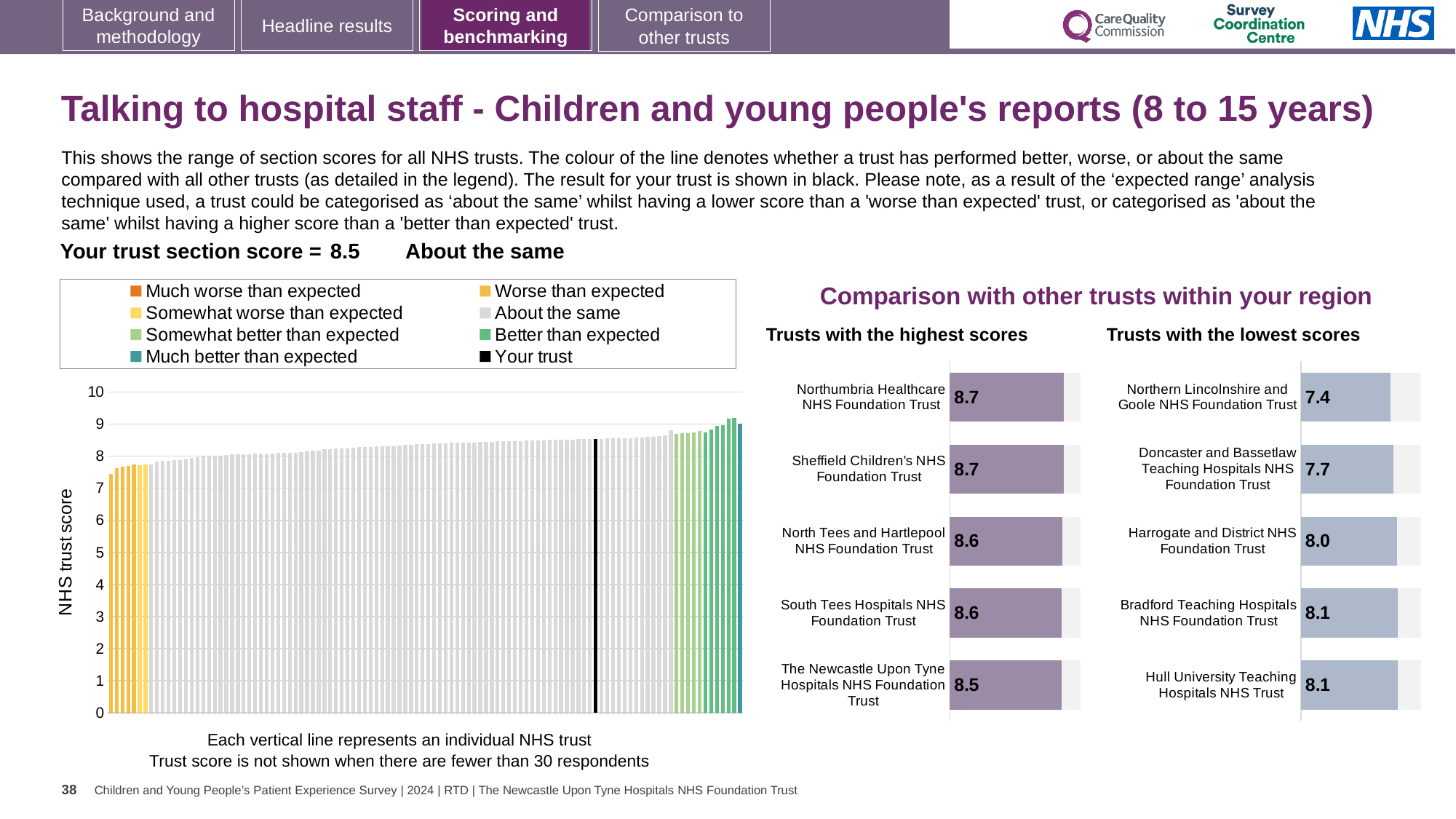
In the main chart on the left, do the trust scores rise or fall from left to right along the x axis? rise In the 'Trusts with the lowest scores' chart, which trust has the lowest score? Northern Lincolnshire and Goole NHS Foundation Trust In the 'Trusts with the lowest scores' chart, what is the difference between the scores of Harrogate and District NHS Foundation Trust and Northern Lincolnshire and Goole NHS Foundation Trust? 0.6 In the main chart on the left, is the value for the black 'Your trust' bar greater or less than 8? greater How many trusts are listed in the 'Trusts with the highest scores' chart? 5 In the 'Trusts with the lowest scores' chart, which has the higher score: Doncaster and Bassetlaw Teaching Hospitals NHS Foundation Trust or Harrogate and District NHS Foundation Trust? Harrogate and District NHS Foundation Trust How many entries does the legend above the main chart on the left list? 8 In the 'Trusts with the lowest scores' chart, what is the score for Harrogate and District NHS Foundation Trust? 8.0 In the 'Trusts with the highest scores' chart, what is the score for The Newcastle Upon Tyne Hospitals NHS Foundation Trust? 8.5 What kind of chart is the main chart on the left showing NHS trust scores? bar chart In the 'Trusts with the highest scores' chart, what is the score for Northumbria Healthcare NHS Foundation Trust? 8.7 In the 'Trusts with the highest scores' chart, what is the difference between the scores of Northumbria Healthcare NHS Foundation Trust and The Newcastle Upon Tyne Hospitals NHS Foundation Trust? 0.2